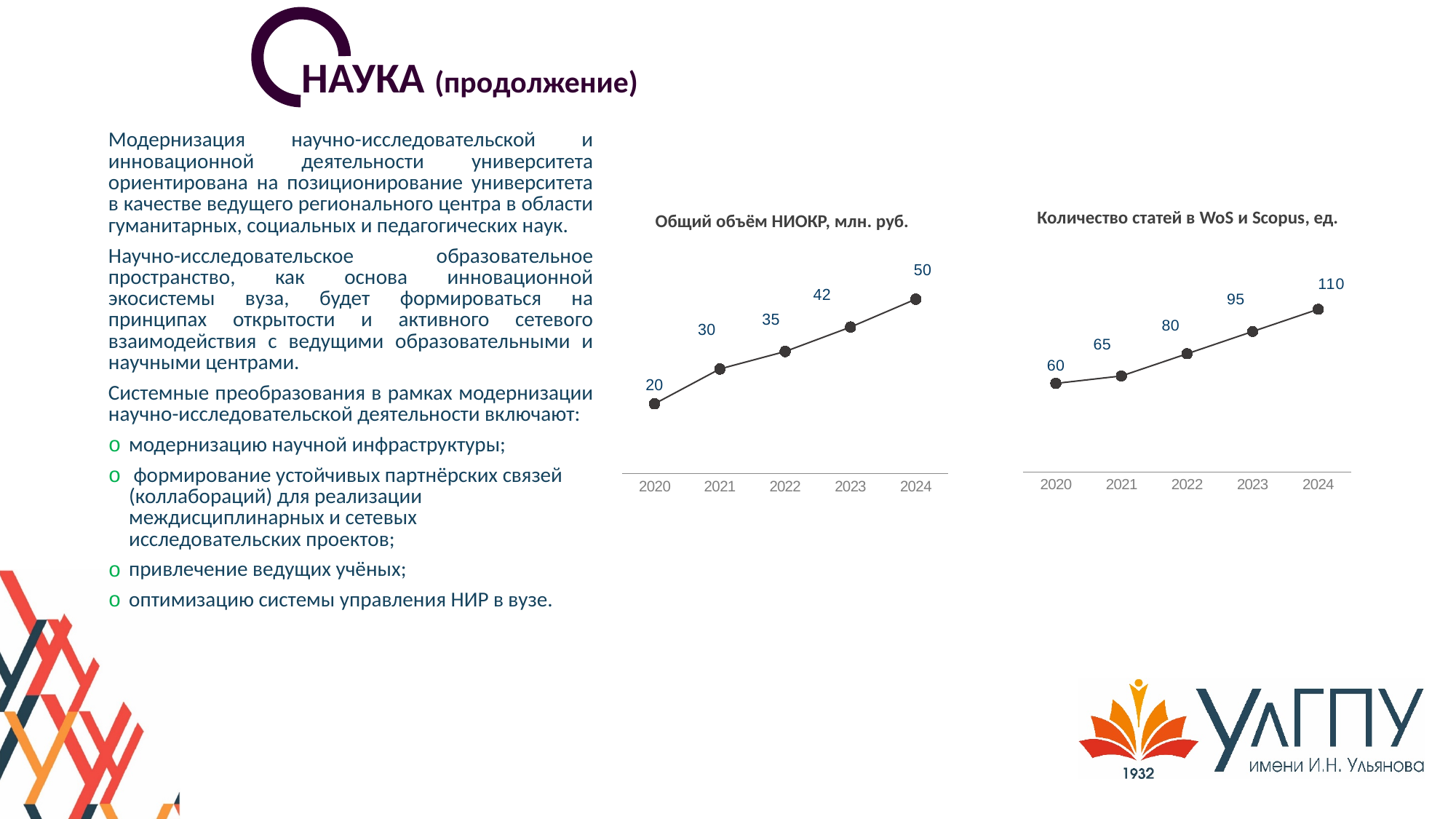
How many data points are plotted in the chart titled "Количество статей в WoS и Scopus, ед."? 5 In the chart titled "Общий объём НИОКР, млн. руб.", which year has the highest value? 2024 In the chart titled "Общий объём НИОКР, млн. руб.", what is the value for 2023? 42 In the chart titled "Количество статей в WoS и Scopus, ед.", which year has the lowest value? 2020 In the chart titled "Количество статей в WoS и Scopus, ед.", do the values rise or fall from 2020 to 2024? rise What is the title of the right-hand chart on the slide? Количество статей в WoS и Scopus, ед. In the chart titled "Общий объём НИОКР, млн. руб.", which is larger: the value for 2021 or the value for 2023? 2023 In the chart titled "Количество статей в WoS и Scopus, ед.", what is the value for 2023? 95 In the chart titled "Количество статей в WoS и Scopus, ед.", what is the difference between the values for 2022 and 2021? 15 In the chart titled "Общий объём НИОКР, млн. руб.", what is the difference between the values for 2024 and 2020? 30 In the chart titled "Общий объём НИОКР, млн. руб.", what is the value for 2022? 35 What kind of chart is the chart titled "Общий объём НИОКР, млн. руб."? line chart